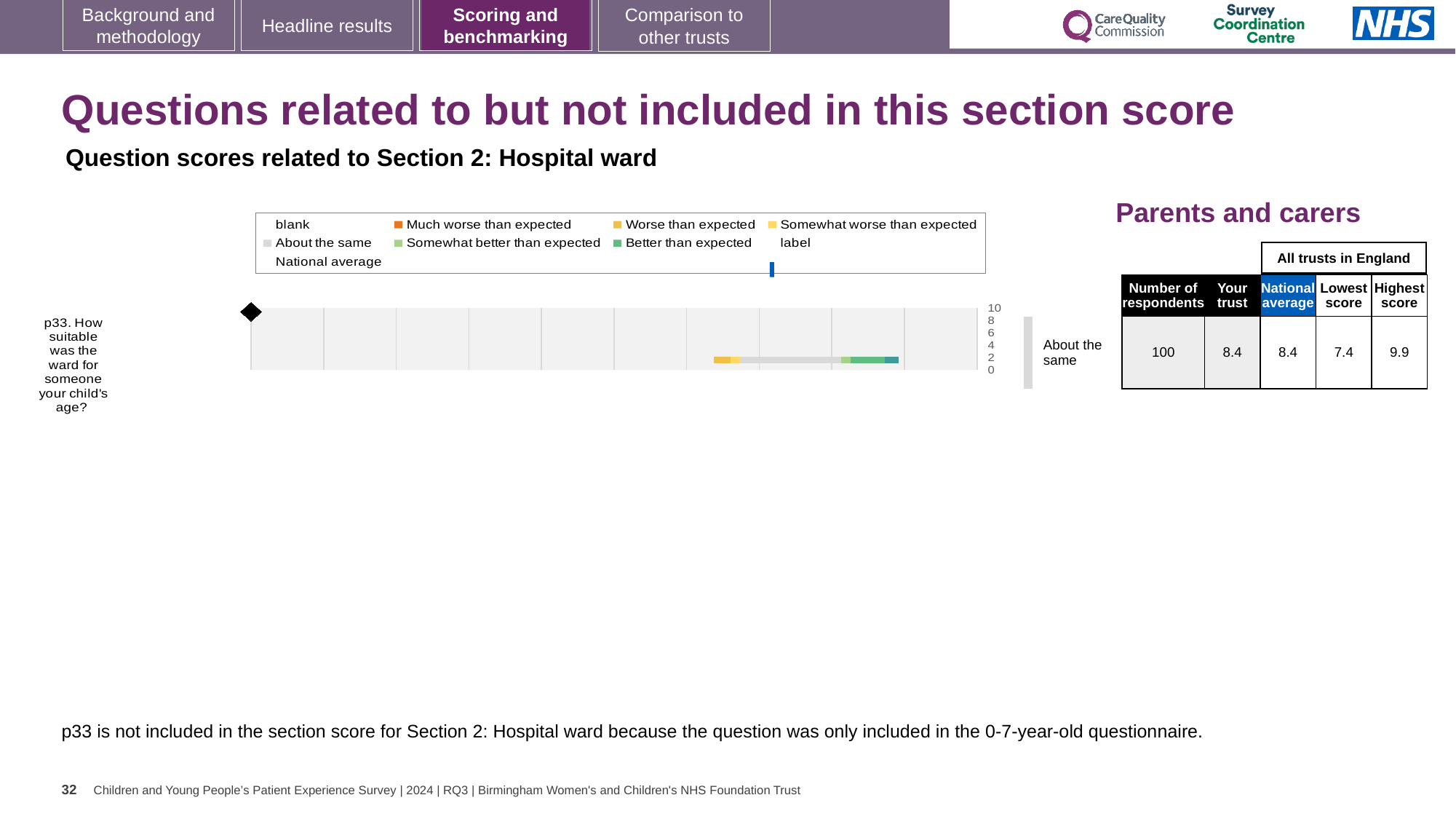
What is the difference between the highest score and the lowest score for p33? 2.5 Is the 'Your trust' score for p33 greater or less than 6 on the axis? greater Which is larger for p33: the highest score or the 'Your trust' score? Highest score Which legend entry is shown in orange? Much worse than expected How many respondents answered p33? 100 What is the lowest score among all trusts in England for p33? 7.4 What is the 'Your trust' score for p33 (How suitable was the ward for someone your child's age?)? 8.4 How many questions are plotted in the chart? 1 What benchmark category is shown next to the p33 bar? About the same What is the national average score for p33? 8.4 What kind of chart is used to show the p33 question score? bar chart What is the highest score among all trusts in England for p33? 9.9